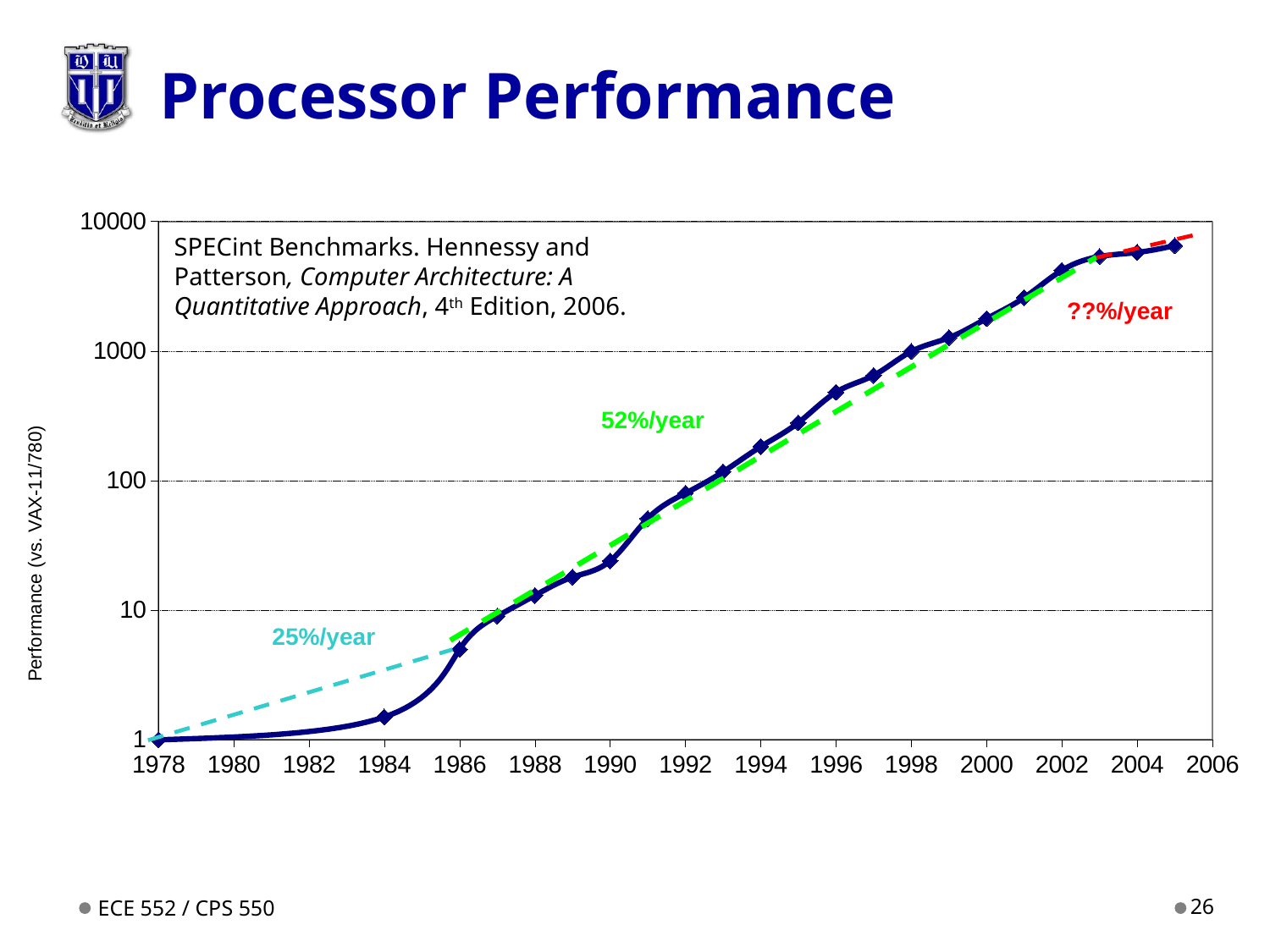
What is the label on the y-axis of the chart? Performance (vs. VAX-11/780) What annual growth rate is labelled on the green dashed trend line? 52%/year Which year has the lowest plotted performance value? 1978 Is the performance value for 2005 greater or less than 10000? less What kind of chart is shown on the slide? line chart Is the performance value for 2000 greater or less than 1000? greater Is the performance value for 1996 greater or less than 100? greater Which year has the highest plotted performance value? 2005 Do the plotted performance values rise or fall from 1978 to 2005? rise